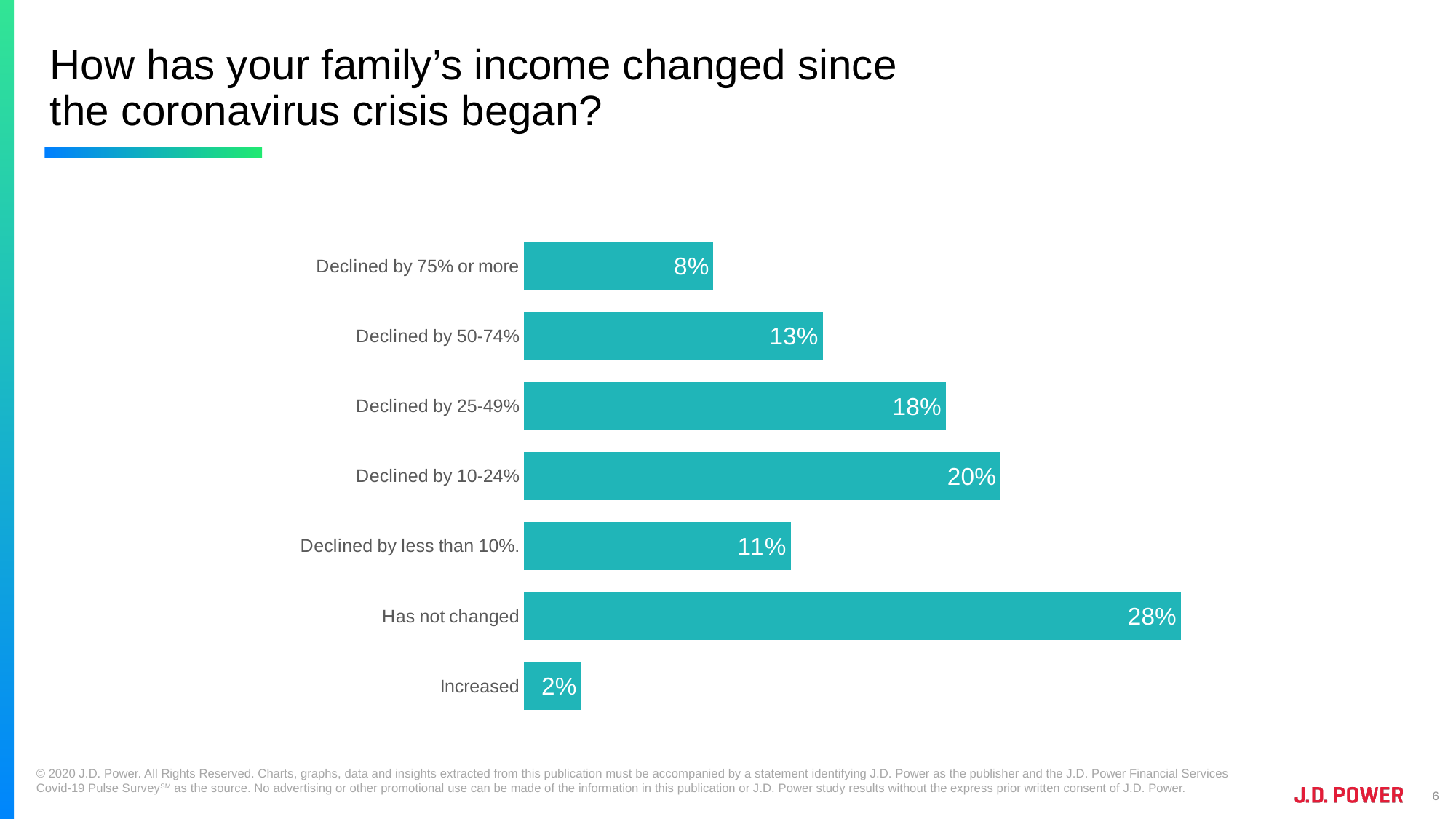
What percentage of respondents said their family's income declined by 10-24%? 20% What is the title of the slide? How has your family's income changed since the coronavirus crisis began? What percentage of respondents said their family's income increased? 2% What kind of chart is shown on the slide? Bar chart How many categories are shown in the chart? 7 What percentage of respondents said their family's income has not changed? 28% Which category has the lowest value? Increased What is the difference between the values for 'Declined by 25-49%' and 'Declined by 50-74%'? 5% Which category has the highest value? Has not changed What percentage of respondents said their family's income declined by 75% or more? 8% What is the difference between the values for 'Has not changed' and 'Declined by 10-24%'? 8% Which is larger: the value for 'Declined by less than 10%.' or the value for 'Declined by 50-74%'? Declined by 50-74%